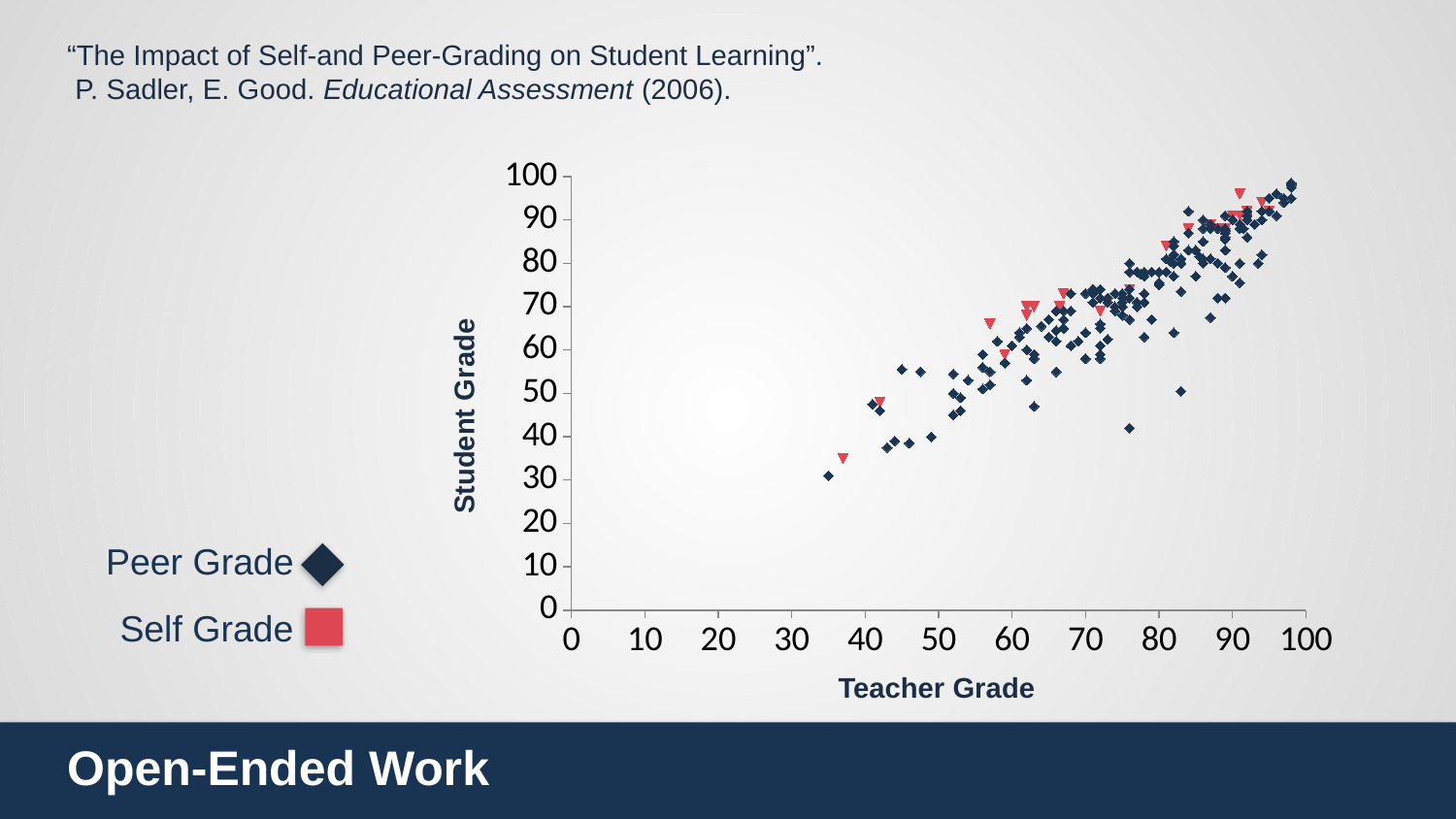
What are the two series named in the legend? Peer Grade and Self Grade As Teacher Grade increases along the x axis, do Student Grade values generally rise or fall? rise What is the label of the y axis? Student Grade What is the highest tick value shown on the y axis? 100 Are there any plotted points with a Teacher Grade less than 30? no How many series does the legend list? 2 What kind of chart is shown on the slide? scatter chart What is the label of the x axis? Teacher Grade Which series is shown with red triangle markers? Self Grade What is the highest tick value shown on the x axis? 100 Is the lowest plotted Student Grade value greater or less than 40? less